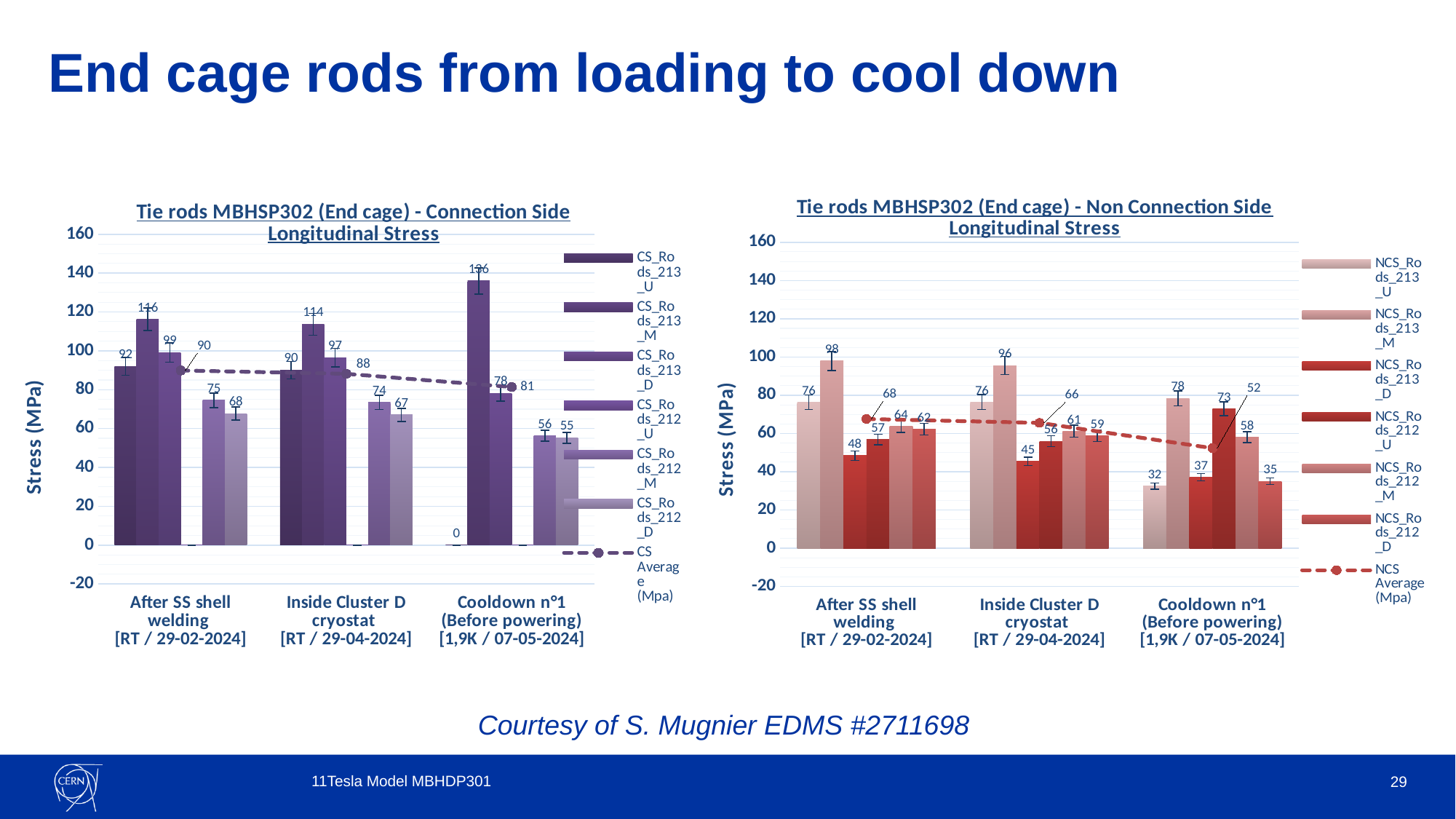
In the Non Connection Side chart, what is the highest bar value in the 'After SS shell welding' group? 98 In the Non Connection Side chart, by how much does the NCS Average drop from 'After SS shell welding' to 'Cooldown n°1 (Before powering)'? 16 In the Non Connection Side chart, what is the lowest bar value in the 'Cooldown n°1 (Before powering)' group? 32 In the Non Connection Side chart, what is the NCS Average value at 'Inside Cluster D cryostat'? 66 How many entries does the legend of the Connection Side chart list? 7 In the Connection Side chart, what is the highest bar value in the 'Cooldown n°1 (Before powering)' group? 136 In the Non Connection Side chart, what is the NCS Average value at 'Cooldown n°1 (Before powering)'? 52 How many categories are shown on the x axis of the Connection Side chart? 3 Which is larger: the CS Average at 'After SS shell welding' in the Connection Side chart or the NCS Average at 'After SS shell welding' in the Non Connection Side chart? CS Average (Connection Side) In the Non Connection Side chart, does the NCS Average line rise or fall from left to right across the x axis? fall In the Connection Side chart, what is the CS Average value at 'Cooldown n°1 (Before powering)'? 81 In the Connection Side chart, what is the CS Average value at 'After SS shell welding'? 90